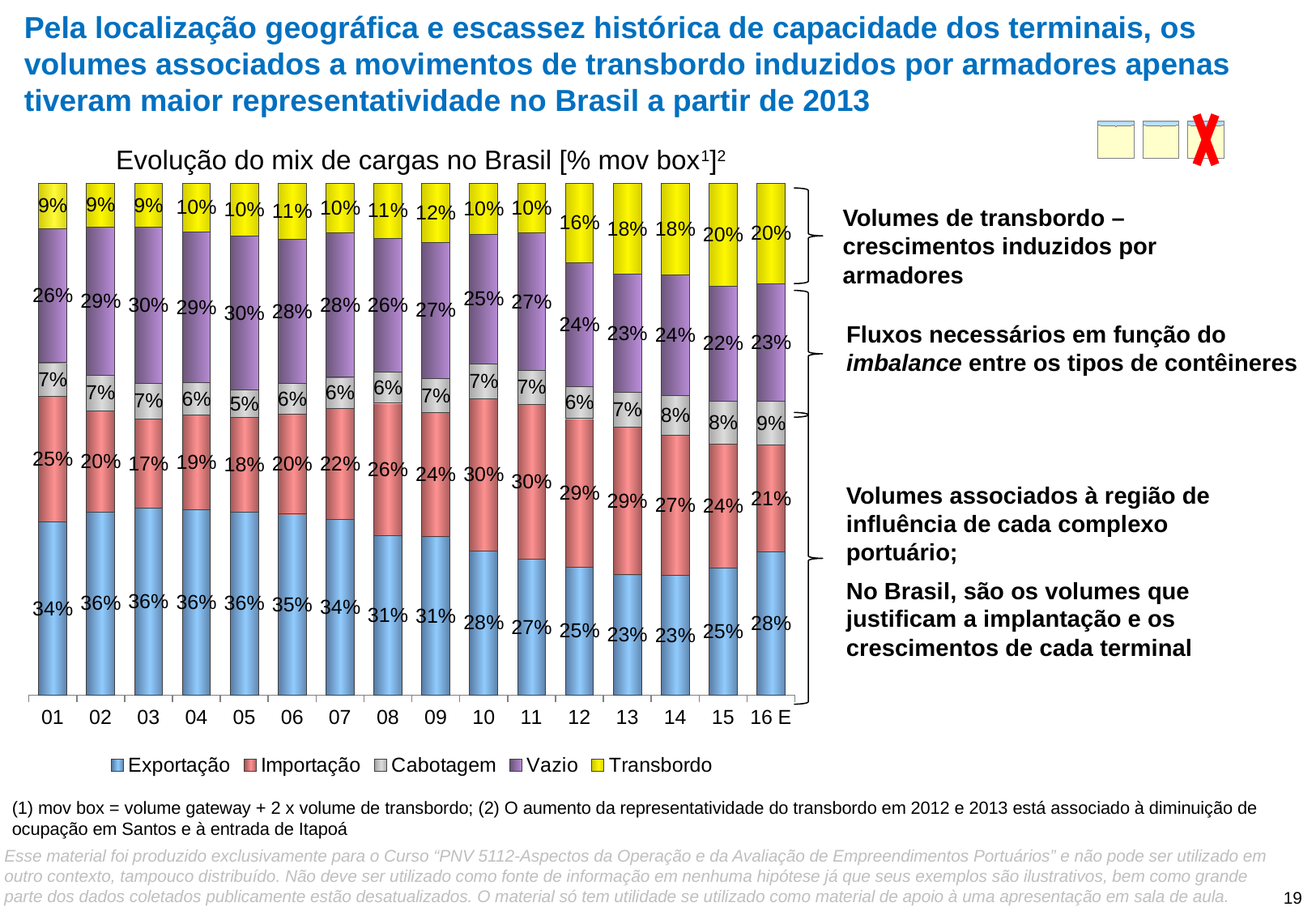
How many series does the legend list? 5 What is the Exportação share for 01? 34% How many years are shown on the x axis? 16 In which year is the Vazio share lowest? 15 By how many percentage points does the Transbordo share in 16 E exceed that in 01? 11 percentage points What is the Vazio share for 12? 24% What is the Transbordo share for 16 E? 20% What kind of chart is shown? Stacked bar chart In which year is the Cabotagem share highest? 16 E Does the Transbordo share rise or fall from 01 to 16 E? Rises In which year is the Cabotagem share lowest? 05 In 10, which is larger: the Importação share or the Exportação share? Importação